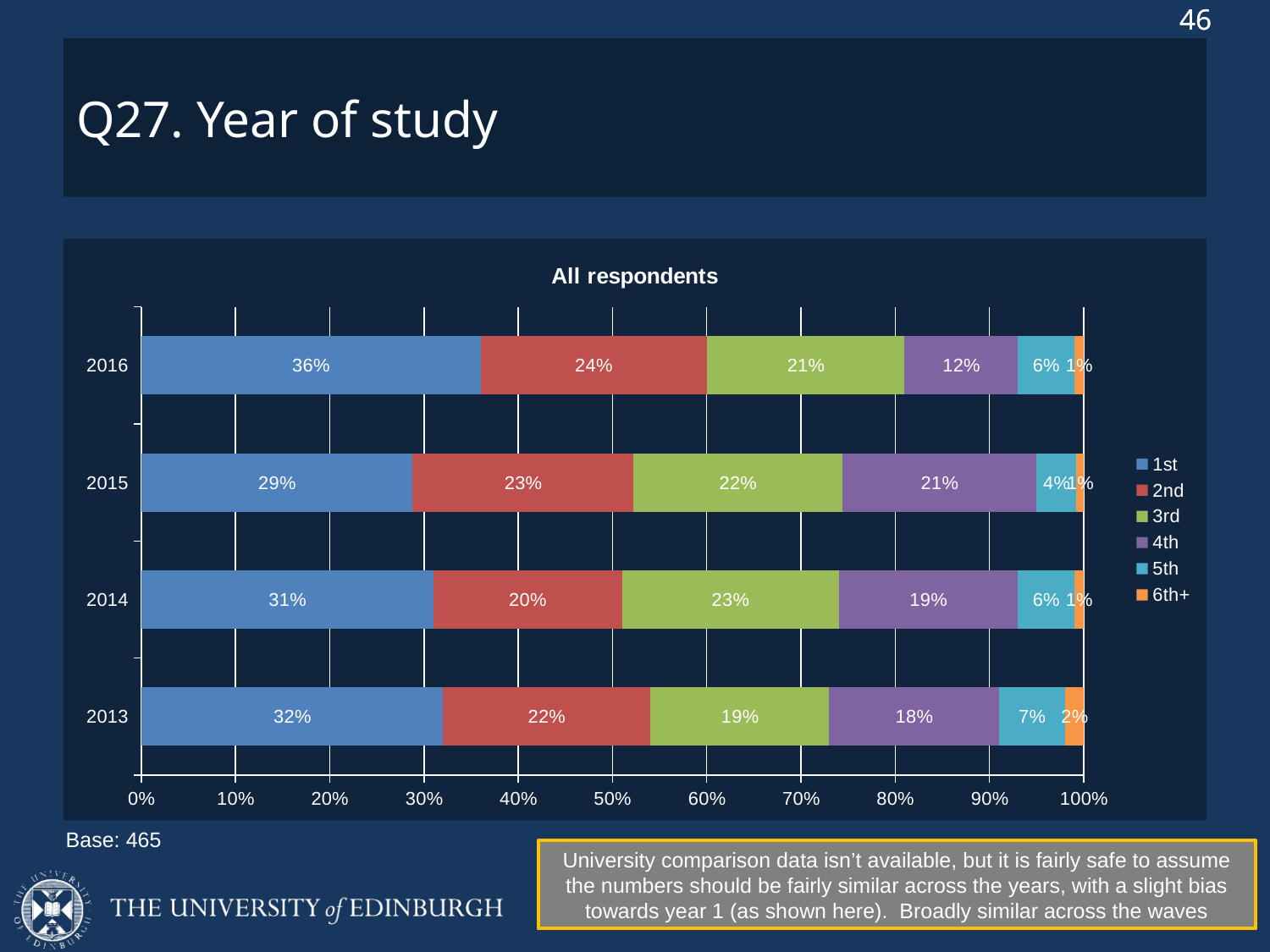
What is the value for 1st year students in 2016? 36% What is the title of the chart? All respondents What is the value for 5th year students in 2013? 7% What is the difference between the 1st year share in 2016 and in 2015? 7% Which year has the lowest share of 4th year students? 2016 How many series does the legend list? 6 Which is larger: the 3rd year share in 2014 or the 3rd year share in 2013? 2014 How many years (categories) are shown on the chart? 4 What kind of chart is shown on the slide? Stacked bar chart Which year has the highest share of 1st year students? 2016 What is the value for 2nd year students in 2014? 20% What is the value for 4th year students in 2015? 21%